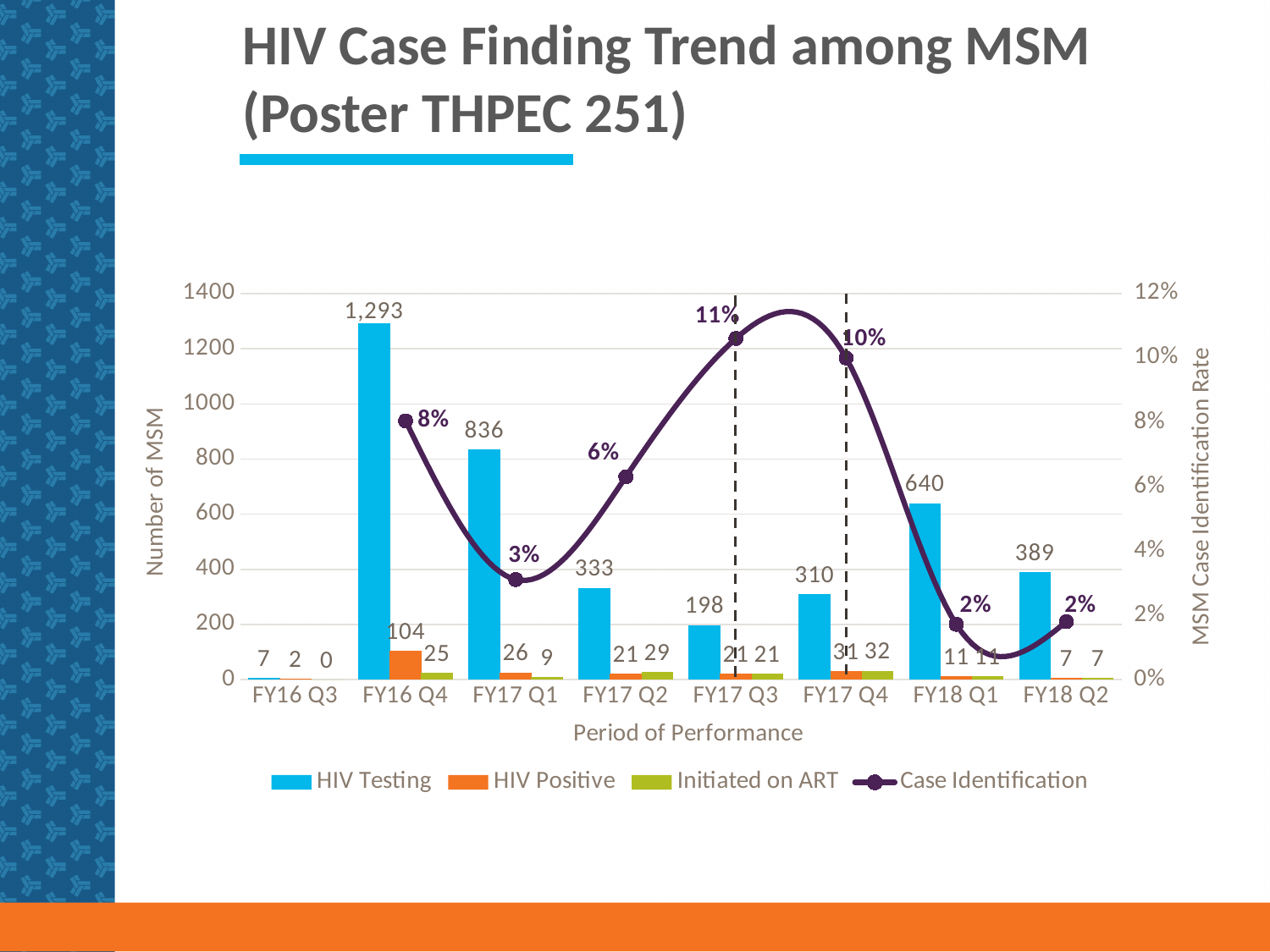
Which period has the highest HIV Testing value? FY16 Q4 Which period has a higher HIV Testing value, FY18 Q1 or FY18 Q2? FY18 Q1 What is the HIV Positive value for FY16 Q4? 104 How many MSM were Initiated on ART in FY17 Q4? 32 Which period has the lowest HIV Testing value? FY16 Q3 What is the title of the right-hand vertical axis? MSM Case Identification Rate What is the HIV Testing value for FY16 Q4? 1,293 What is the difference in HIV Testing between FY16 Q4 and FY17 Q1? 457 What kind of chart is this? Combined bar and line chart How many series does the legend list? 4 How many periods are shown on the x axis? 8 What is the Case Identification rate for FY17 Q3? 11%